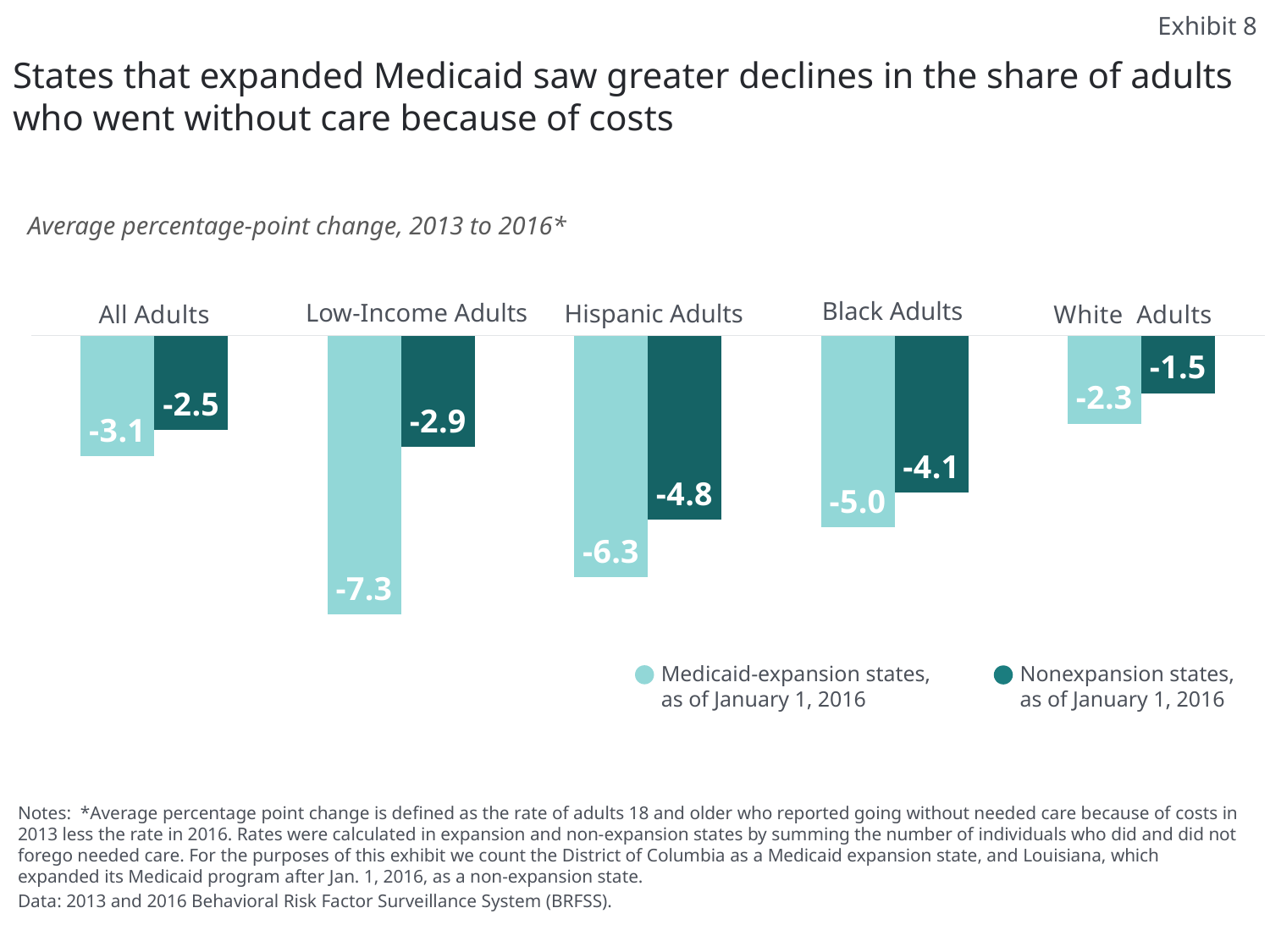
Which is lower, the Medicaid-expansion value for Black Adults or the Medicaid-expansion value for Hispanic Adults? Hispanic Adults What kind of chart is shown on the slide? Bar chart How many series does the legend list? 2 Which category has the smallest decline (highest value) for Nonexpansion states? White Adults What is the difference between the Medicaid-expansion and Nonexpansion values for Low-Income Adults? 4.4 What is the value for White Adults in Medicaid-expansion states? -2.3 What is the value for Low-Income Adults in Medicaid-expansion states? -7.3 Which category has the largest decline (lowest value) for Medicaid-expansion states? Low-Income Adults What is the value for All Adults in Nonexpansion states? -2.5 What is the value for Black Adults in Nonexpansion states? -4.1 What is the difference between the Medicaid-expansion and Nonexpansion values for Hispanic Adults? 1.5 How many categories of adults are shown on the chart? 5